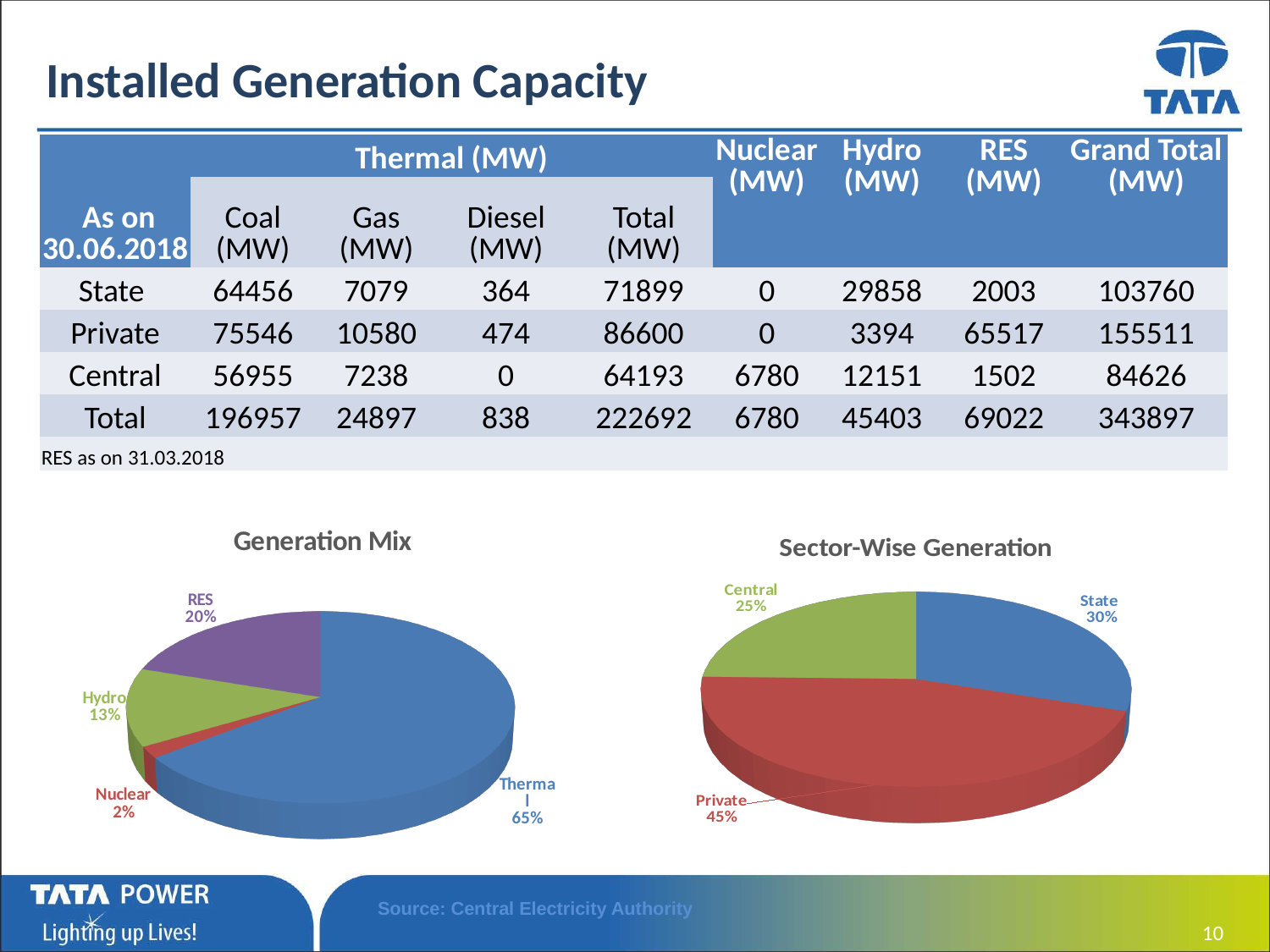
In the Generation Mix chart, what share does Thermal have? 65% In the Generation Mix chart, how many slices does the pie have? 4 In the Sector-Wise Generation chart, which sector has the largest share? Private In the Sector-Wise Generation chart, what share does Private have? 45% In the Sector-Wise Generation chart, what share does Central have? 25% In the Sector-Wise Generation chart, which is larger, State or Central? State What type of chart is the Sector-Wise Generation chart? Pie chart In the Generation Mix chart, what is the difference in percentage points between the RES and Hydro shares? 7 In the Generation Mix chart, which category has the largest share? Thermal In the Generation Mix chart, which category has the smallest share? Nuclear